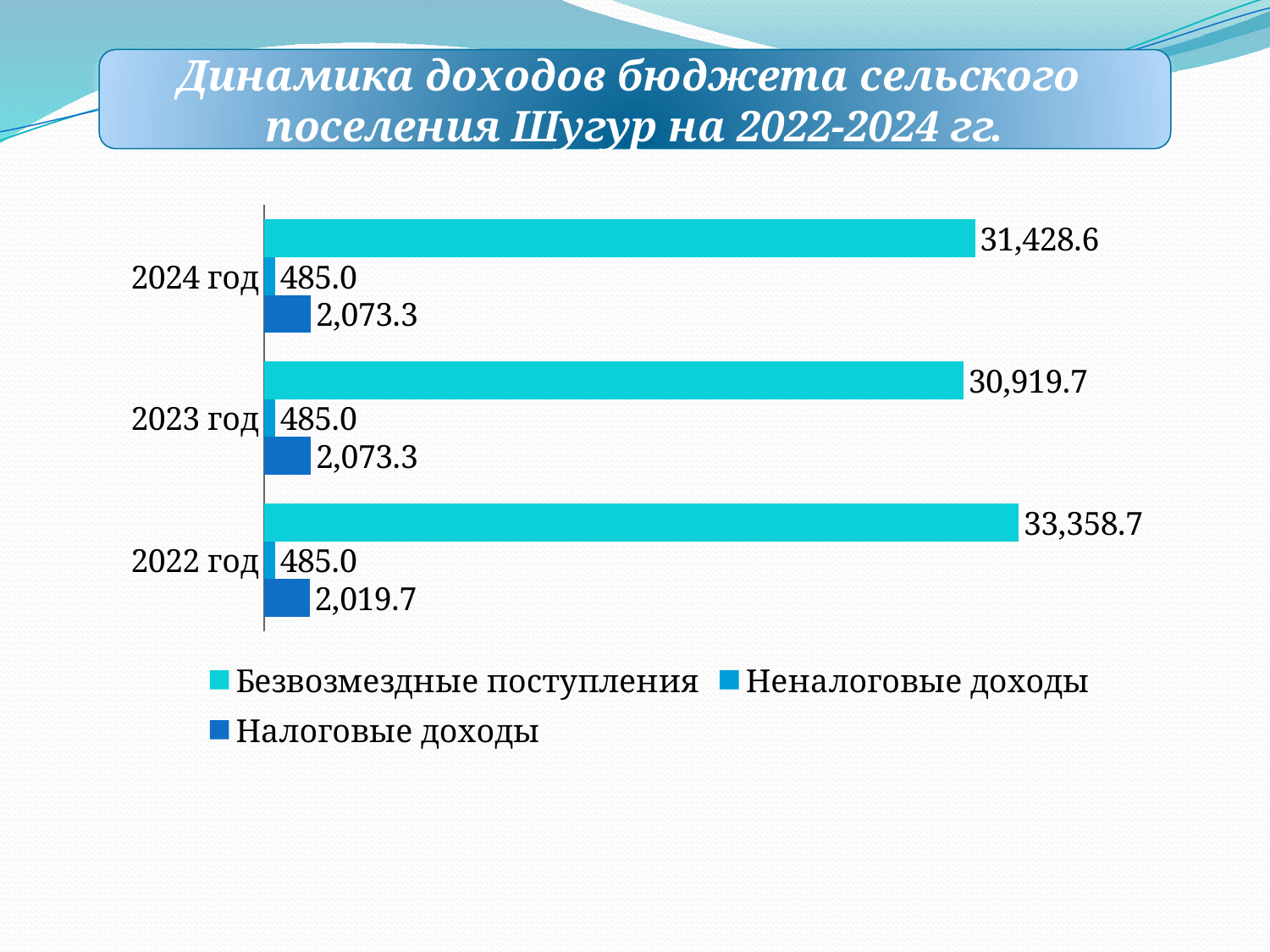
In which year is Безвозмездные поступления lowest? 2023 год How many years (categories) are shown on the chart? 3 What is the value of Неналоговые доходы for 2023 год? 485.0 What type of chart is shown on the slide? Bar chart What is the difference between Налоговые доходы in 2024 год and 2022 год? 53.6 What is the difference between Безвозмездные поступления in 2022 год and 2023 год? 2,439.0 What is the value of Налоговые доходы for 2023 год? 2,073.3 Which is larger: Безвозмездные поступления in 2024 год or in 2023 год? 2024 год How many series does the legend list? 3 What is the value of Безвозмездные поступления for 2024 год? 31,428.6 In which year is Безвозмездные поступления highest? 2022 год What is the value of Налоговые доходы for 2022 год? 2,019.7